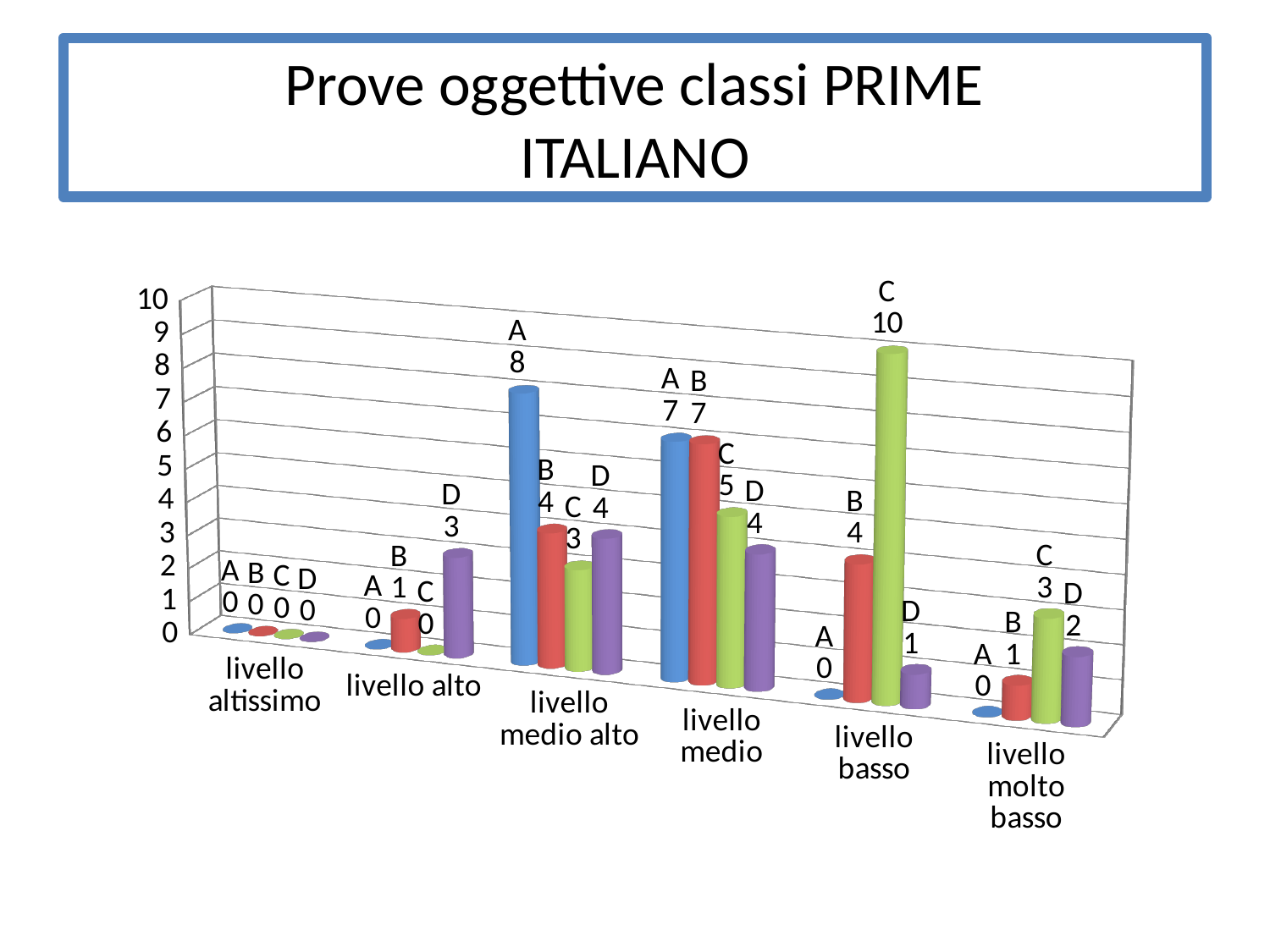
Which is larger at livello medio: series B or series C? series B Which category has the highest value for series A? livello medio alto What is the value for series C at livello basso? 10 What is the value for series D at livello alto? 3 What is the value for series A at livello medio alto? 8 What is the value for series B at livello molto basso? 1 Which category has the highest value for series C? livello basso What is the difference between series A and series C at livello medio alto? 5 What is the title of the slide? Prove oggettive classi PRIME ITALIANO What is the difference between series C and series B at livello basso? 6 How many categories are shown on the x axis? 6 What kind of chart is shown on the slide? bar chart